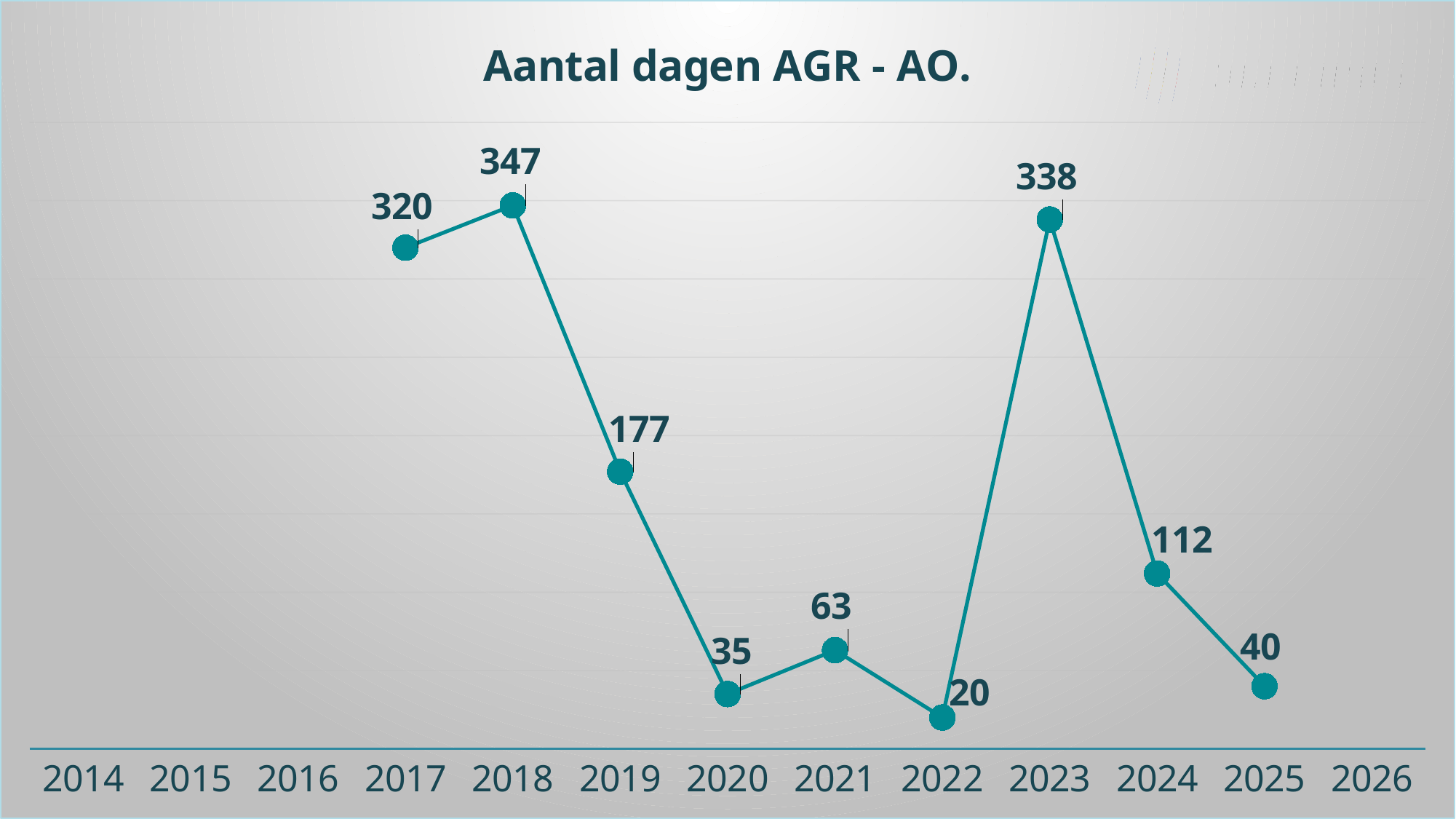
Which year has the highest value? 2018 What is the value for 2024? 112 How many data points are plotted on the chart? 9 Which year has the lowest value? 2022 Which is larger, the value for 2020 or the value for 2021? 2021 What is the difference between the values for 2023 and 2024? 226 What is the difference between the values for 2017 and 2018? 27 What kind of chart is shown? line chart What is the value for 2018? 347 What is the title of the chart? Aantal dagen AGR - AO. What is the value for 2022? 20 Do the values rise or fall from 2018 to 2022? fall